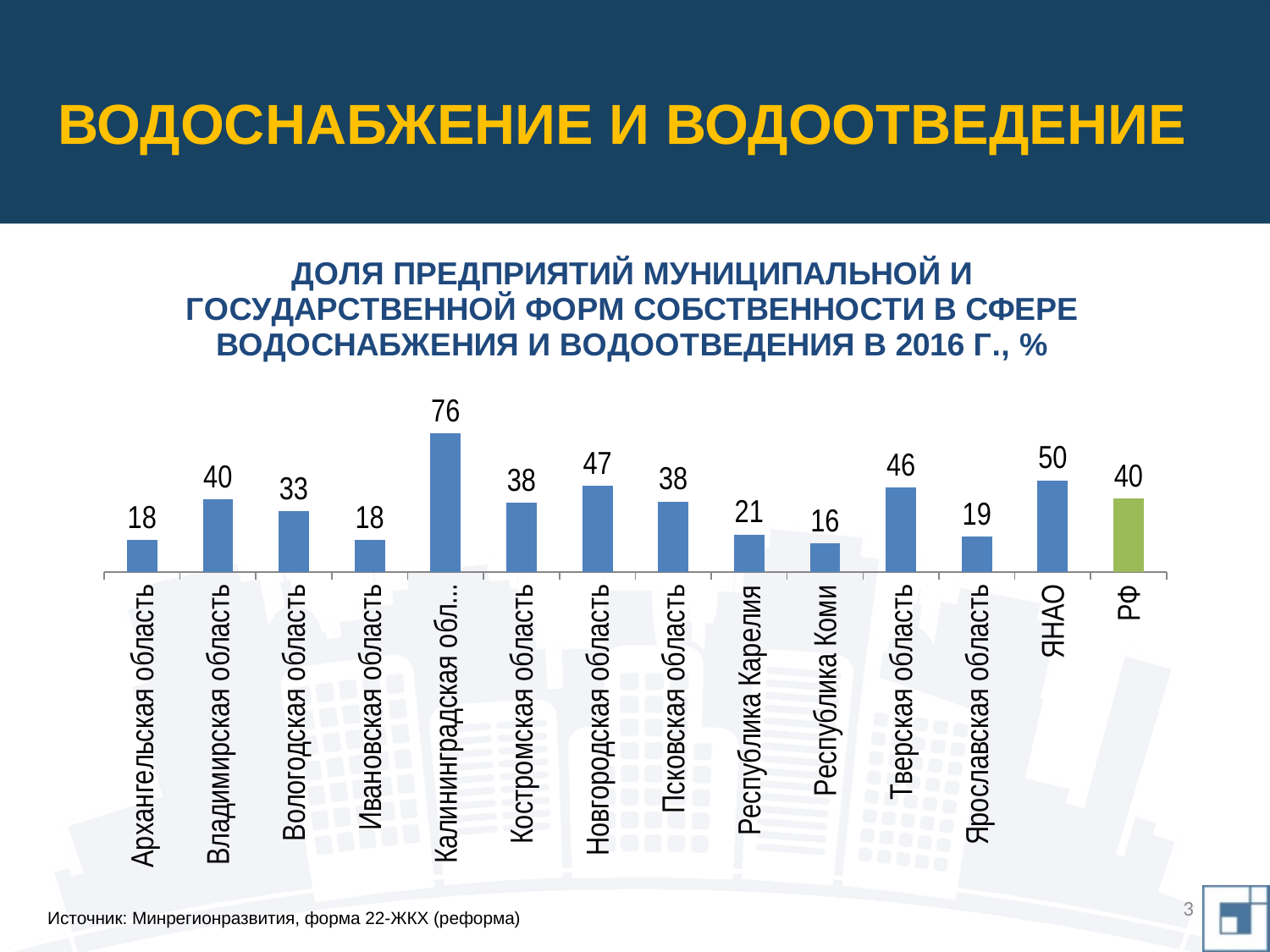
Which category has the highest value? Калининградская обл... Which bar is shown in a different colour (green) from the others? РФ What is the value for РФ? 40 What kind of chart is shown on the slide? bar chart Which category has the lowest value? Республика Коми How many categories are shown on the x axis? 14 What is the value for Новгородская область? 47 What is the difference between the values for Тверская область and Ярославская область? 27 Which is larger, the value for Вологодская область or the value for Костромская область? Костромская область What is the value for ЯНАО? 50 What is the value for Республика Коми? 16 What is the difference between the value for ЯНАО and the value for РФ? 10